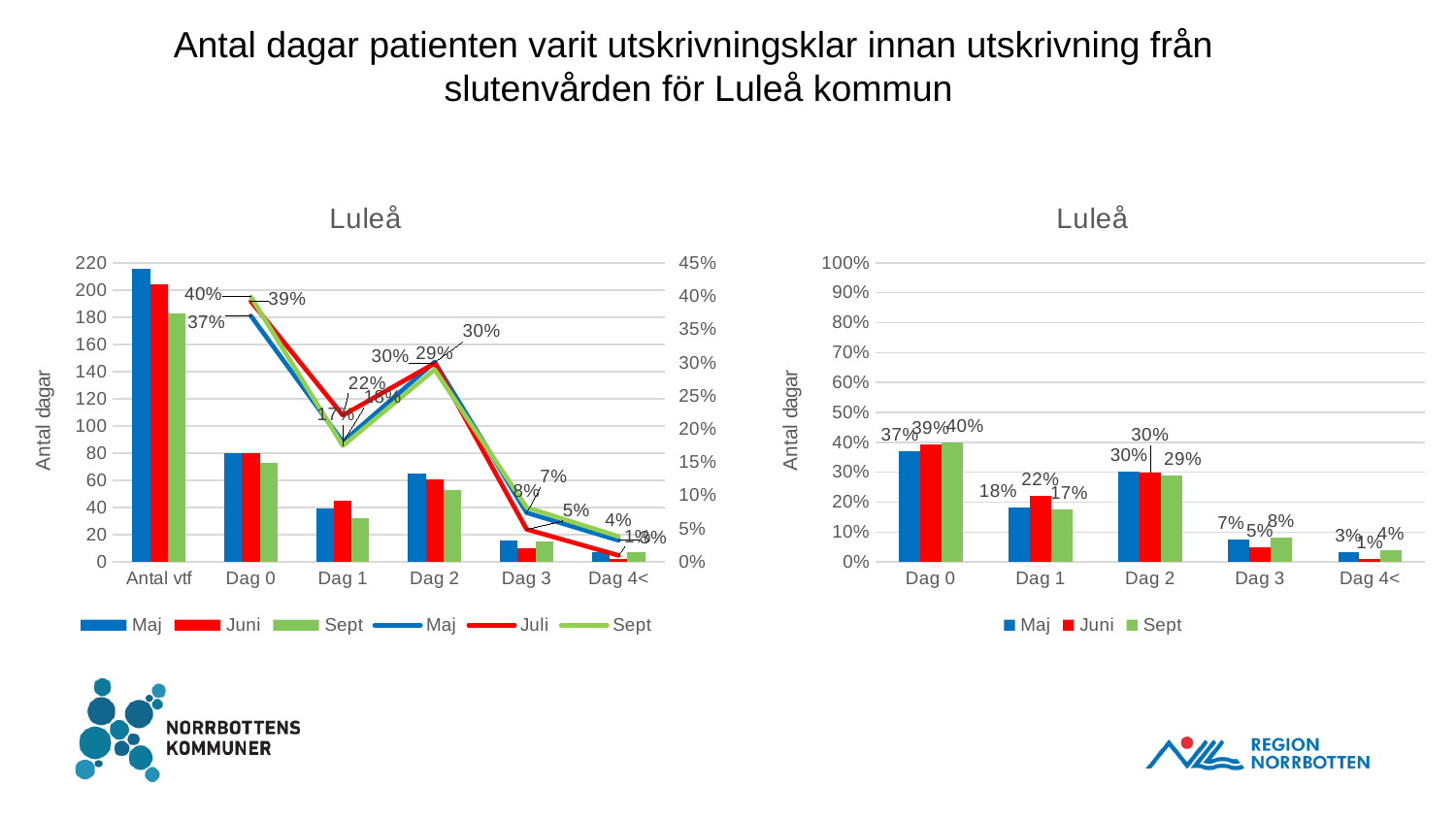
In the right chart, how many categories are shown on the x axis? 5 In the right chart, which is larger at Dag 3: the value for Maj or the value for Sept? Sept In the left chart, how many series does the legend list? 6 In the right chart, how many series does the legend list? 3 In the right chart, what is the value for Sept at Dag 0? 40% In the left chart, is the Maj bar for Antal vtf greater or less than 200? greater In the right chart, which category has the highest value for Maj? Dag 0 In the right chart, what is the value for Juni at Dag 1? 22% In the left chart, is the Sept bar for Dag 1 greater or less than 40? less In the right chart, which category has the lowest value for Juni? Dag 4< In the right chart, what is the value for Maj at Dag 4<? 3% In the right chart, what is the difference between the Juni and Sept values at Dag 1? 5%